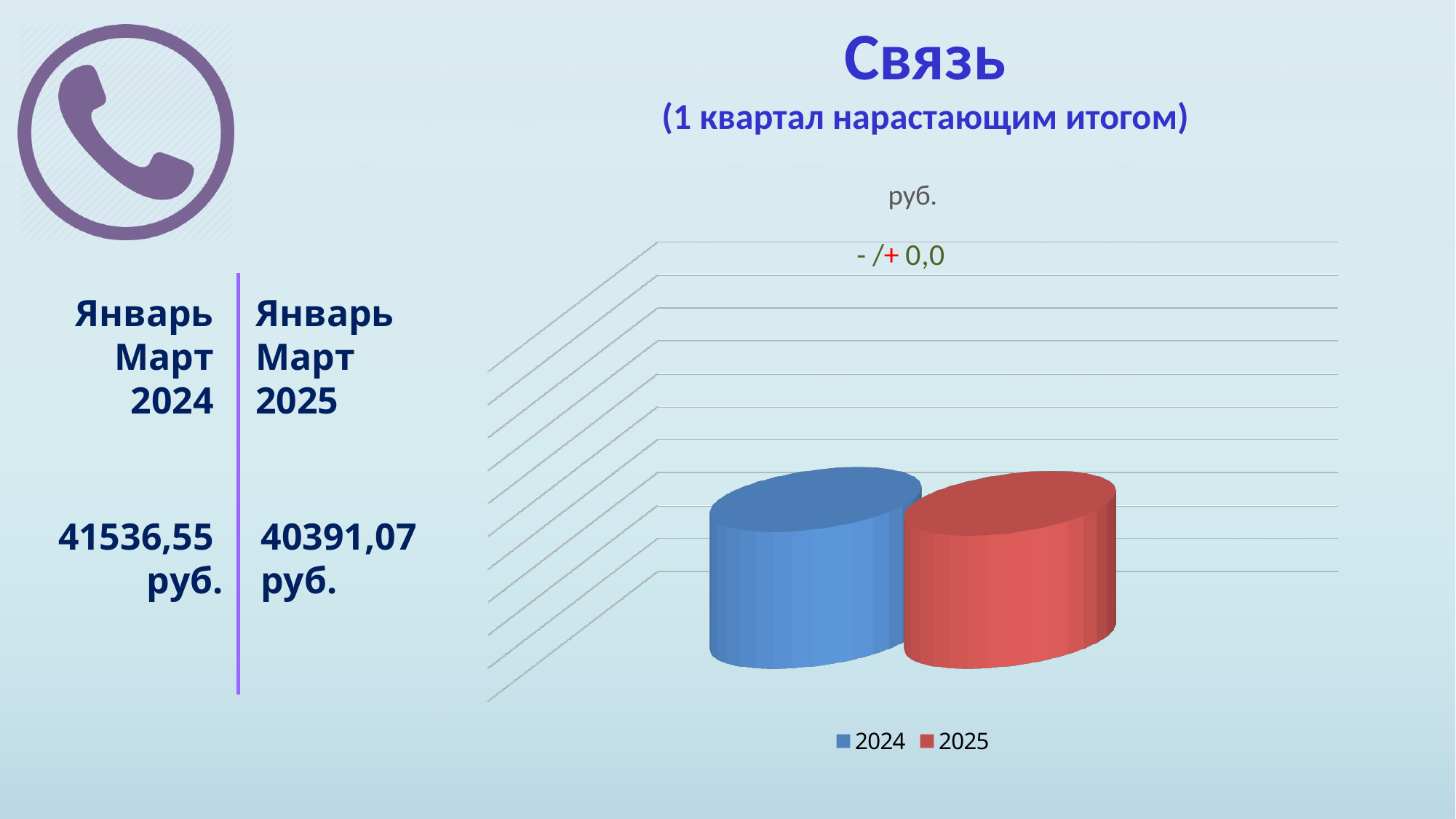
What is the value for January–March 2024 shown on the slide? 41536,55 руб. How many bars are plotted in the chart? 2 Which colour represents the 2025 series in the chart? red Which series has the highest value in the chart? 2024 Do the values fall or rise from 2024 to 2025? fall Which series has the lowest value in the chart? 2025 What kind of chart is shown on the slide? bar chart How many series does the chart legend list? 2 What are the series names listed in the chart legend? 2024, 2025 What is the difference between the 2024 value and the 2025 value? 1145,48 руб. What is the value for January–March 2025 shown on the slide? 40391,07 руб. Which year has the higher value, 2024 or 2025? 2024